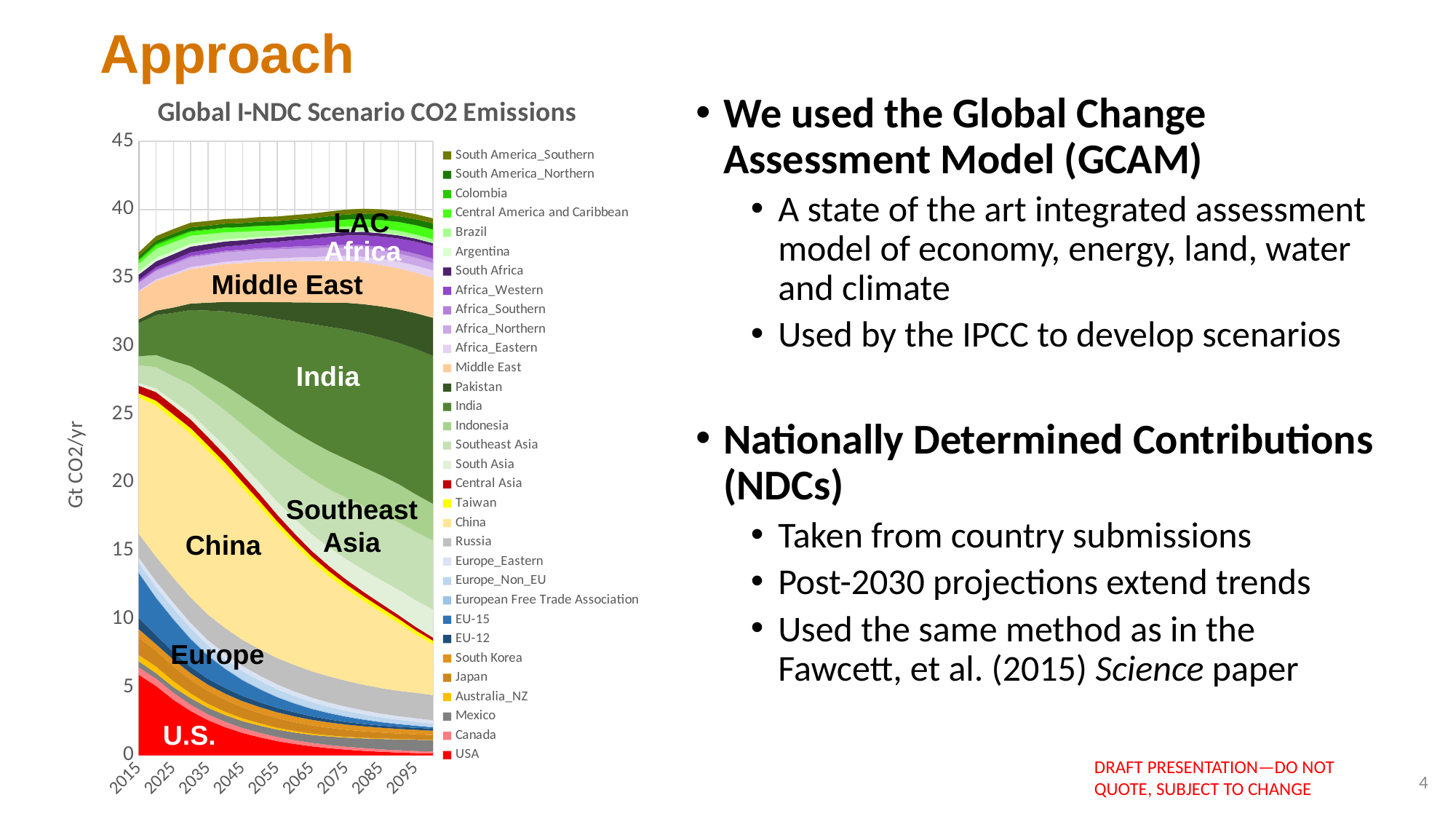
How many year tick labels are shown along the x axis of the chart? 9 What is the last year shown on the x axis of the chart? 2095 Does the U.S. emissions band rise or fall from 2015 to 2095? fall What kind of chart is shown on the slide? stacked area chart How many series does the chart's legend list? 32 Is the total stacked emissions value in 2015 greater or less than 35 Gt CO2/yr? greater What is the maximum value shown on the vertical axis of the chart? 45 What is the label on the vertical axis of the chart? Gt CO2/yr What is the title of the chart on the slide? Global I-NDC Scenario CO2 Emissions What is the first year shown on the x axis of the chart? 2015 Does the India emissions band grow or shrink from 2015 to 2095? grow Is the U.S. emissions value in 2015 greater or less than 5 Gt CO2/yr? greater